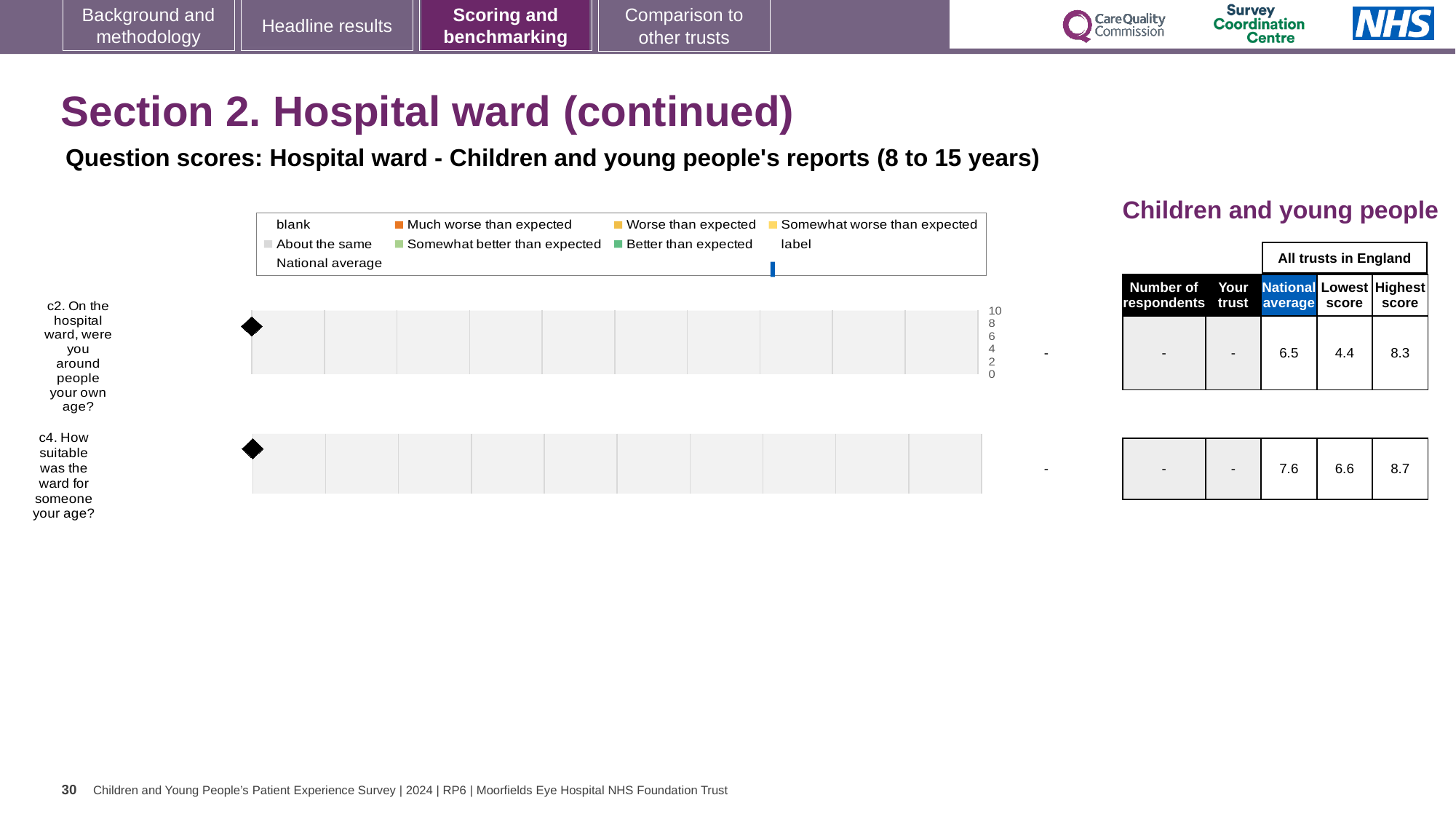
What kind of chart is used for the question scores? Bar chart What is the difference between the national average scores for c4 and c2? 1.1 What is the maximum value shown on the chart's score axis? 10 Which question has the higher national average, c2 or c4? c4 What is the national average score for c2 (On the hospital ward, were you around people your own age?)? 6.5 What is the difference between the highest and lowest scores for c4? 2.1 What is the lowest score among all trusts in England for c4? 6.6 What is the lowest score among all trusts in England for c2? 4.4 How many survey questions are plotted on the chart? 2 What is the highest score among all trusts in England for c4 (How suitable was the ward for someone your age?)? 8.7 What is the difference between the highest and lowest scores for c2? 3.9 What is shown as the 'Your trust' score for c2? -